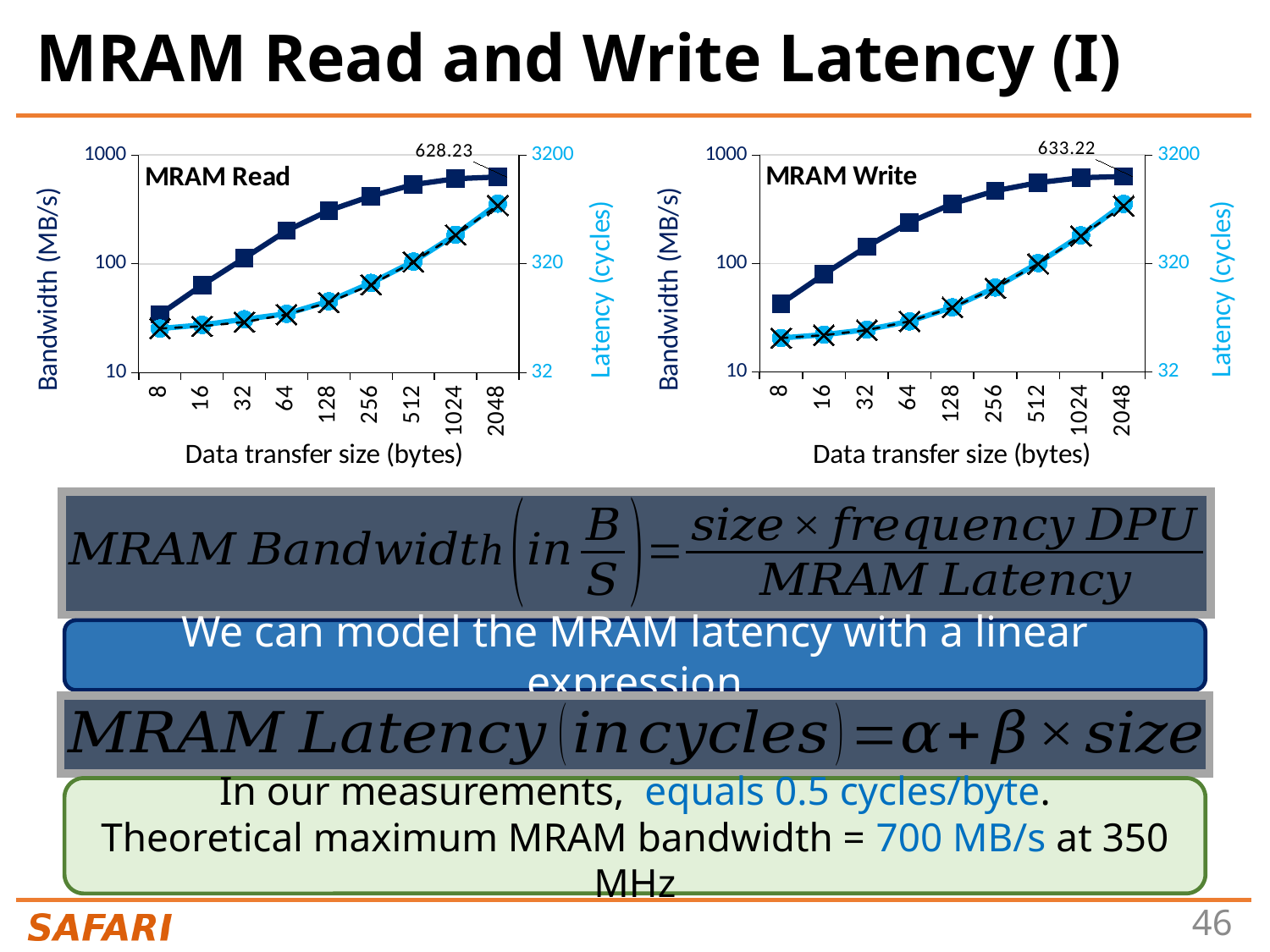
Which is larger: the labelled bandwidth at 2048 bytes in the MRAM Read chart or in the MRAM Write chart? MRAM Write In the MRAM Read chart, is the bandwidth at a data transfer size of 8 bytes greater or less than 100 MB/s? less What kind of chart is the MRAM Write chart? Line chart In the MRAM Write chart, is the latency at a data transfer size of 2048 bytes greater or less than 320 cycles? greater In the MRAM Read chart, does the bandwidth rise or fall as the data transfer size increases? Rises What is the difference between the labelled bandwidth at 2048 bytes in the MRAM Write chart and in the MRAM Read chart? 4.99 What is the label of the x axis in the MRAM Read chart? Data transfer size (bytes) How many data transfer sizes are plotted on the x axis of the MRAM Read chart? 9 In the MRAM Write chart, at which data transfer size is the bandwidth highest? 2048 In the MRAM Read chart, at which data transfer size is the bandwidth lowest? 8 In the MRAM Read chart, what is the bandwidth value labelled at a data transfer size of 2048 bytes? 628.23 In the MRAM Write chart, what is the bandwidth value labelled at a data transfer size of 2048 bytes? 633.22